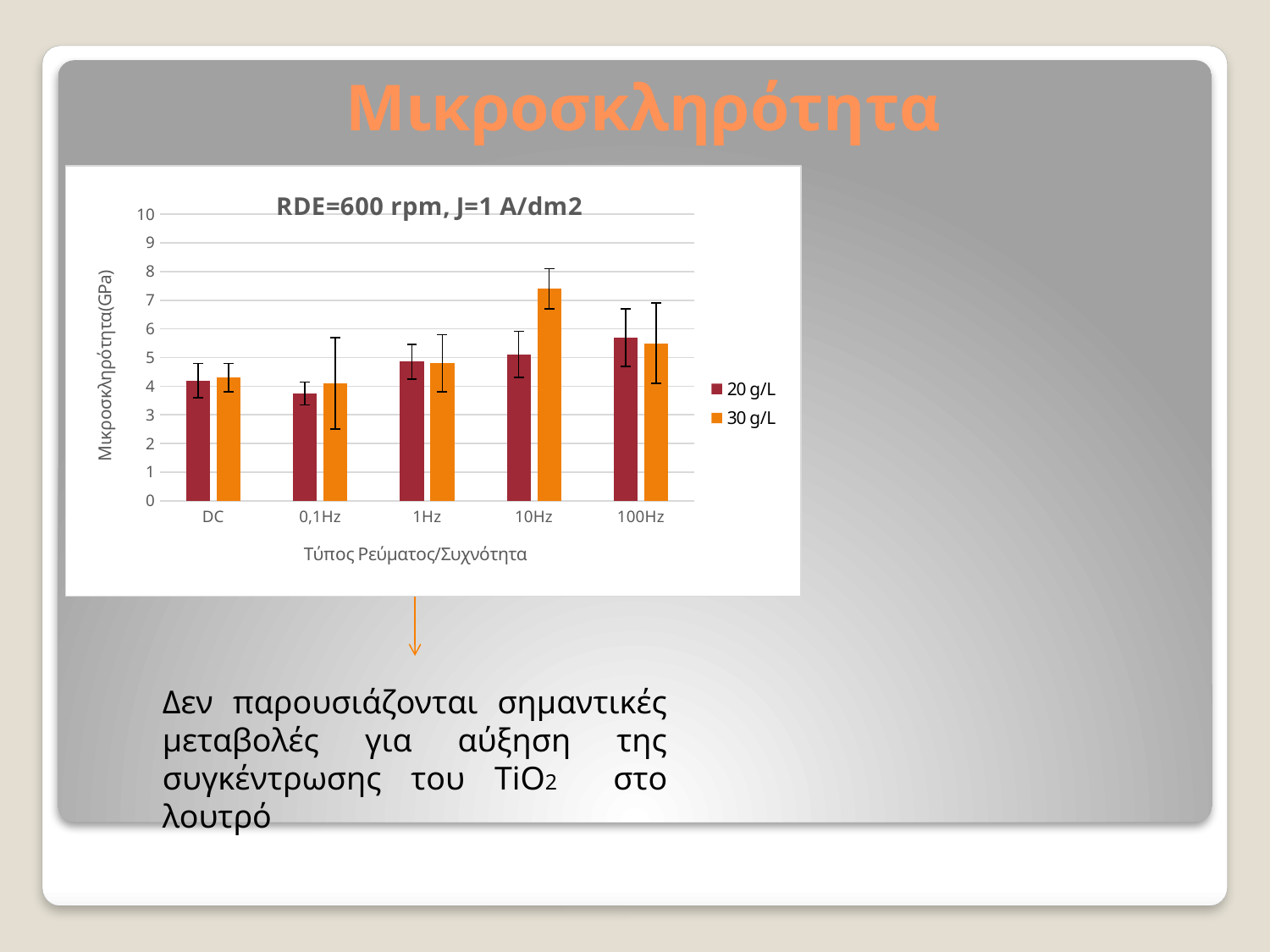
What kind of chart is shown on the slide? bar chart How many series does the chart's legend list? 2 What is the label of the chart's x axis? Τύπος Ρεύματος/Συχνότητα Is the value for 20 g/L at 0,1Hz greater or less than 4? less Is the value for 30 g/L at 10Hz greater or less than 7? greater Which category has the lowest value for the 20 g/L series? 0,1Hz How many categories are shown on the x axis of the chart? 5 For the 30 g/L series, which is larger, the value at 10Hz or the value at DC? 10Hz Is the value for 20 g/L at 100Hz greater or less than 5? greater At 10Hz, which series has the larger value, 20 g/L or 30 g/L? 30 g/L What is the title of the chart? RDE=600 rpm, J=1 A/dm2 Which category has the highest value for the 30 g/L series? 10Hz